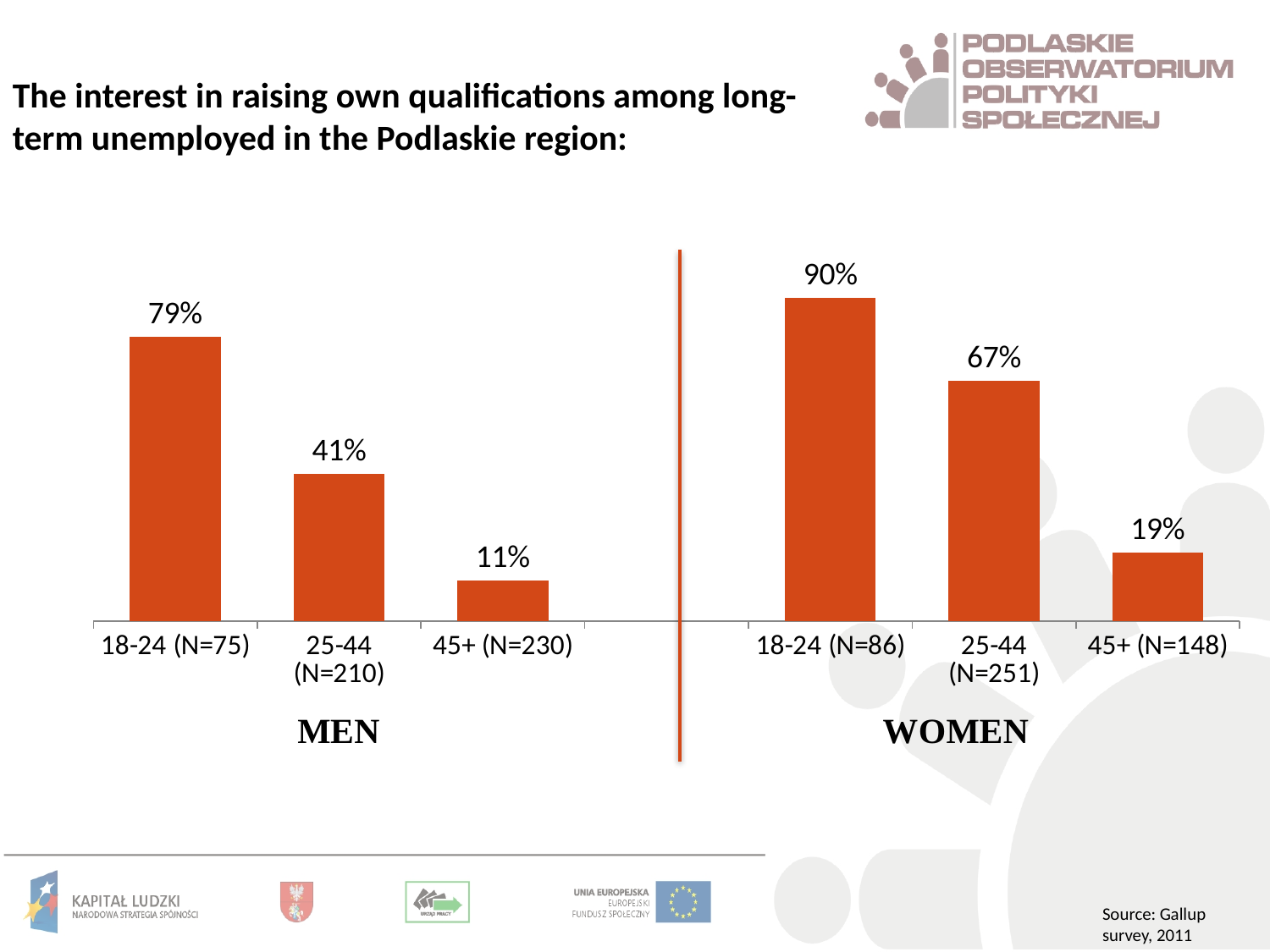
How many age groups are shown in the MEN chart? 3 In the WOMEN chart, what is the difference between the 18-24 (N=86) and 45+ (N=148) values? 71% Which is larger: the 25-44 value in the MEN chart or the 25-44 value in the WOMEN chart? WOMEN (67%) In the WOMEN chart, what is the value for the 25-44 (N=251) group? 67% In the MEN chart, what is the value for the 18-24 (N=75) group? 79% In the MEN chart, which age group has the lowest value? 45+ (N=230) In the WOMEN chart, do the values rise or fall as age increases along the x axis? Fall In the MEN chart, what is the value for the 45+ (N=230) group? 11% In the WOMEN chart, which age group has the highest value? 18-24 (N=86) In the MEN chart, what is the difference between the 18-24 (N=75) and 25-44 (N=210) values? 38% What kind of chart is used for the WOMEN data? Bar chart What is the source cited for the data on the slide? Gallup survey, 2011